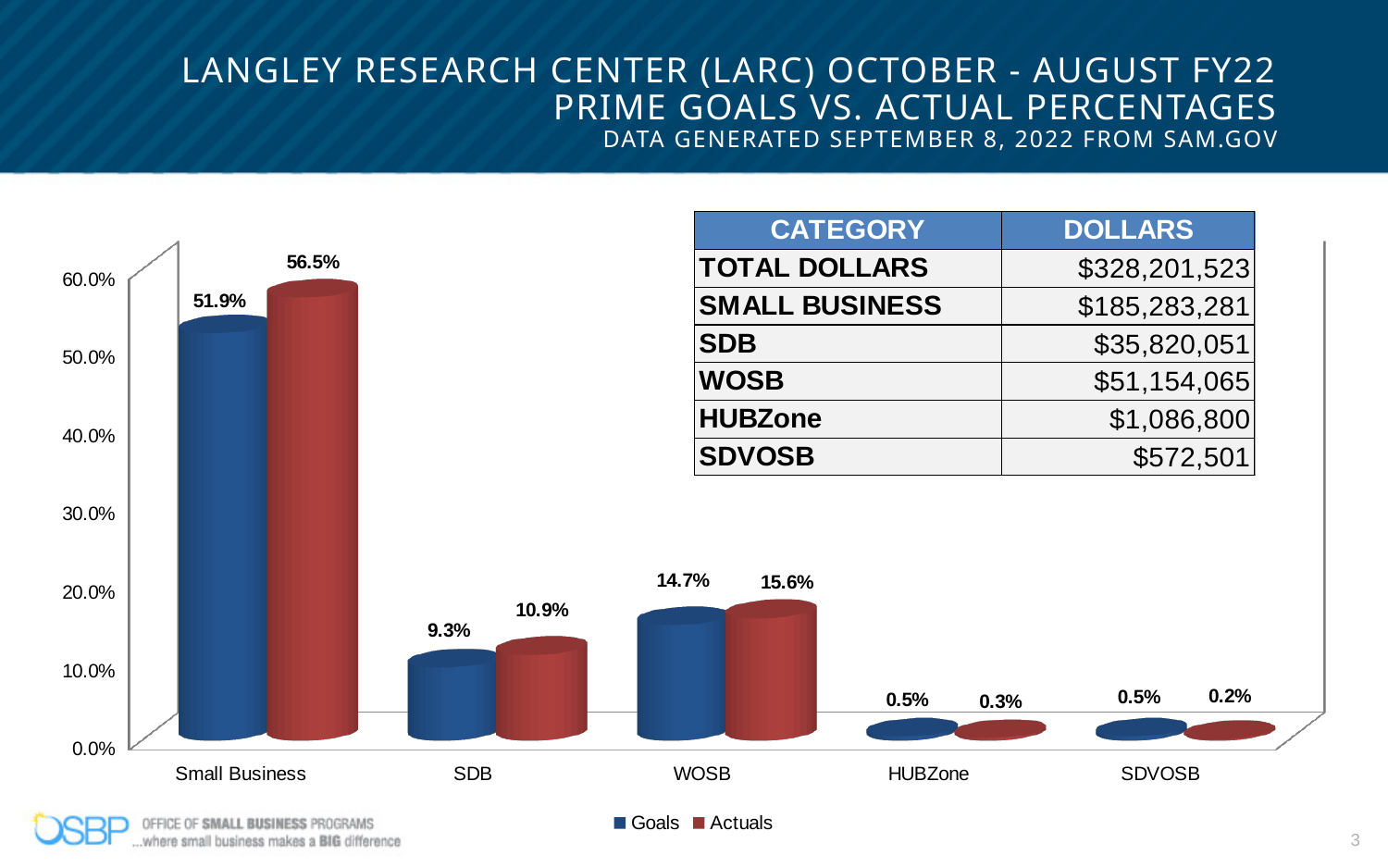
What is the Actuals value for SDB? 10.9% How many series does the chart legend list? 2 What is the Goals value for HUBZone? 0.5% What kind of chart is shown on the slide? Bar chart What is the Goals value for Small Business? 51.9% What is the difference between the Actuals and Goals values for Small Business? 4.6% Is the Goals value for WOSB greater or less than 10.0%? greater Which category has the lowest Actuals value? SDVOSB Which is larger for SDVOSB, the Goals value or the Actuals value? Goals What is the Actuals value for WOSB? 15.6% How many categories are shown on the x axis of the chart? 5 Which category has the highest Actuals value? Small Business